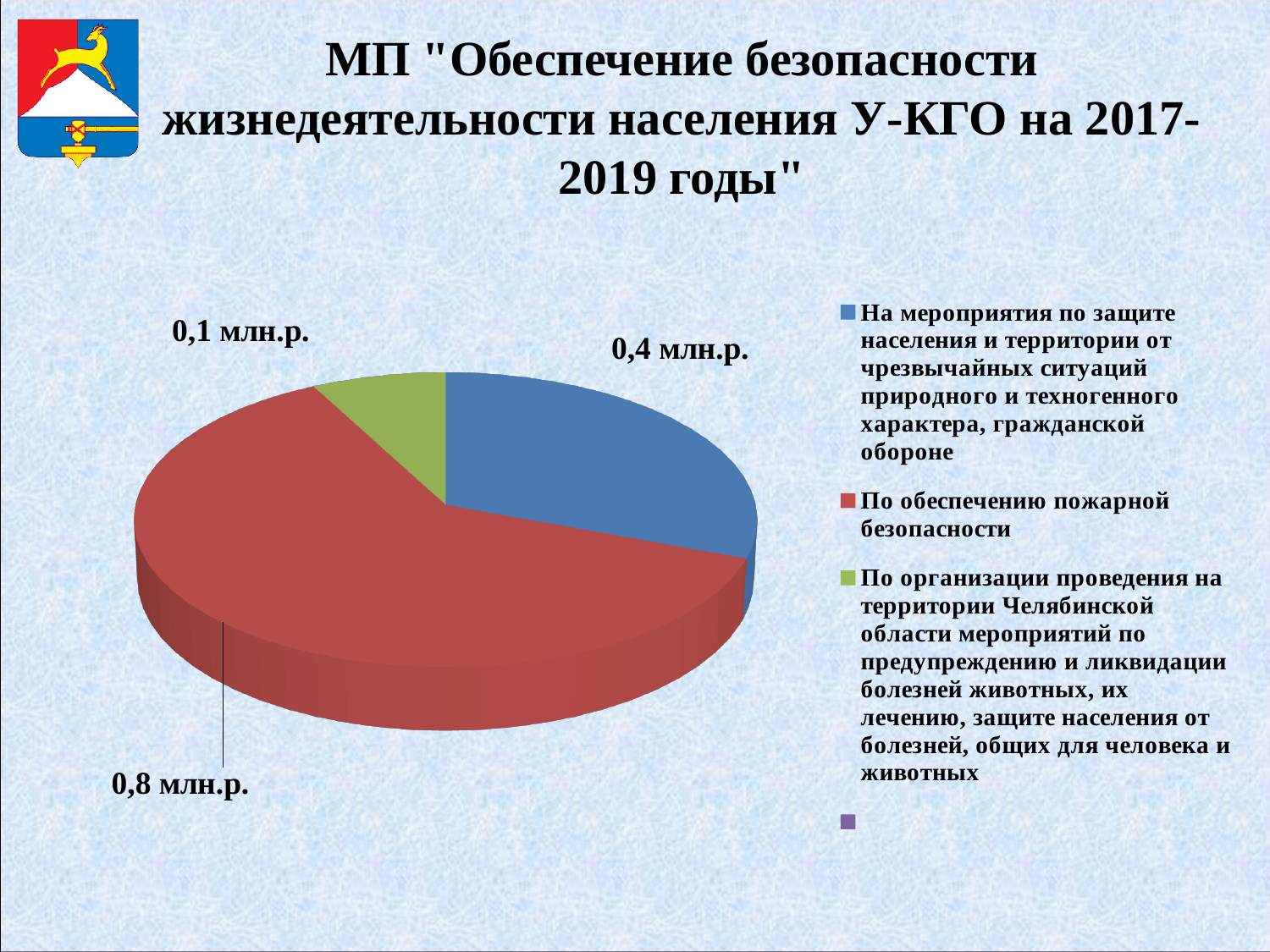
How many slices does the pie chart have? 3 Which is larger: the value for "На мероприятия по защите населения..." or the value for "По организации проведения... болезней животных..."? На мероприятия по защите населения... What kind of chart is shown on the slide? pie chart Which category has the smallest slice of the pie? По организации проведения на территории Челябинской области мероприятий по предупреждению и ликвидации болезней животных, их лечению, защите населения от болезней, общих для человека и животных What is the value for "По организации проведения на территории Челябинской области мероприятий по предупреждению и ликвидации болезней животных..."? 0,1 млн.р. What is the title of the slide containing the chart? МП "Обеспечение безопасности жизнедеятельности населения У-КГО на 2017-2019 годы" What colour is the slice for "По обеспечению пожарной безопасности"? red What is the total of all the values shown on the pie chart? 1,3 млн.р. Which category has the largest slice of the pie? По обеспечению пожарной безопасности What is the value for "На мероприятия по защите населения и территории от чрезвычайных ситуаций природного и техногенного характера, гражданской обороне"? 0,4 млн.р. What is the value for "По обеспечению пожарной безопасности"? 0,8 млн.р. What is the difference between the value for fire safety ("По обеспечению пожарной безопасности") and the value for emergency protection ("На мероприятия по защите населения...")? 0,4 млн.р.